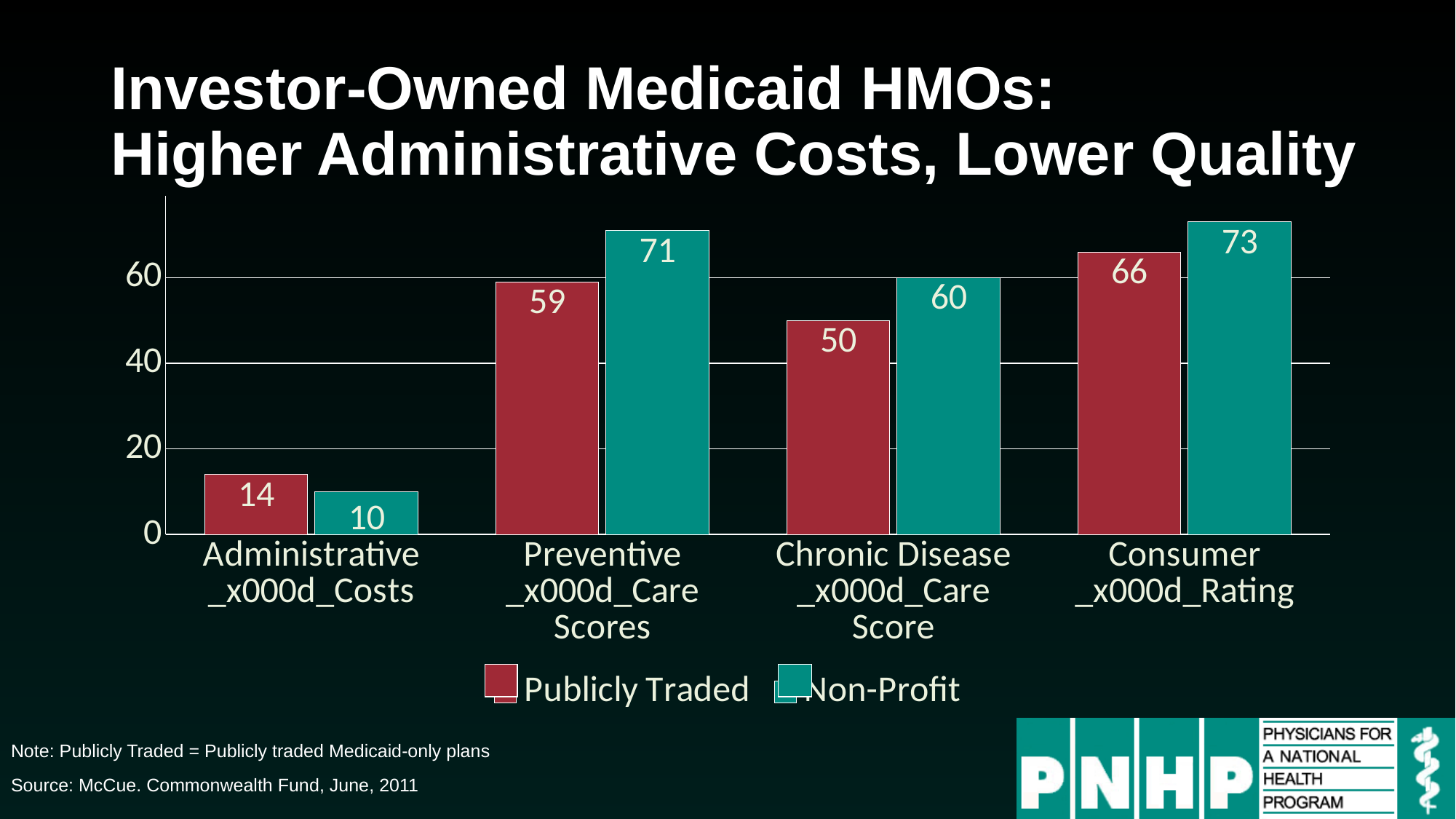
What is the Non-Profit value for Consumer Rating? 73 What is the Publicly Traded value for Administrative Costs? 14 How many categories are shown on the x axis? 4 What kind of chart is shown on the slide? Bar chart What is the Non-Profit value for Preventive Care Scores? 71 What is the Publicly Traded value for Chronic Disease Care Score? 50 Which is larger for Administrative Costs: the Publicly Traded value or the Non-Profit value? Publicly Traded Which category has the lowest Publicly Traded value? Administrative Costs Which series is shown in red? Publicly Traded Which category has the highest Non-Profit value? Consumer Rating How many series does the legend list? 2 What is the difference between the Non-Profit and Publicly Traded values for Preventive Care Scores? 12